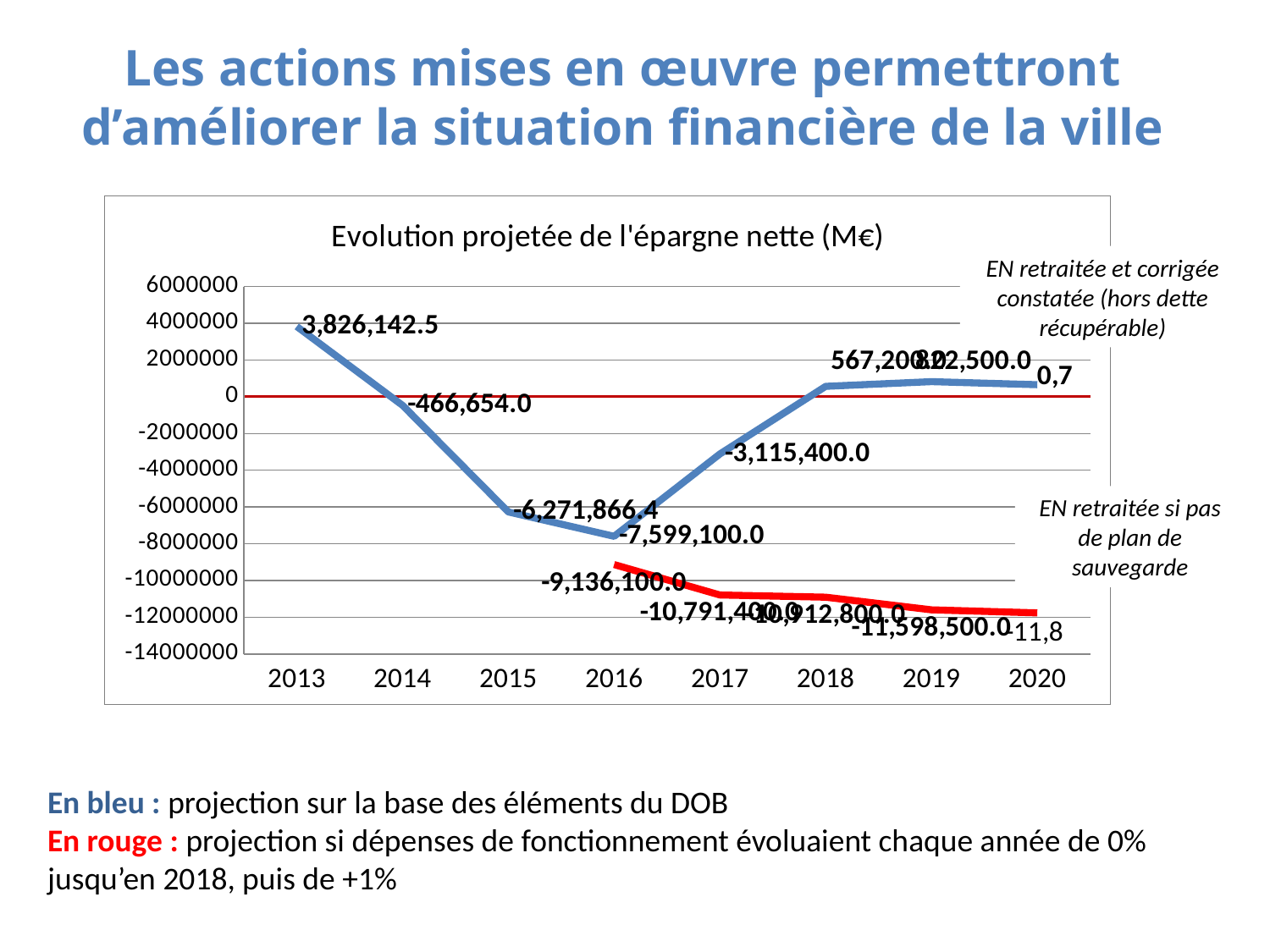
What is the value of the red line in 2019? -11,598,500.0 Does the blue line rise or fall between 2013 and 2016? fall What is the value of the red line (EN retraitée si pas de plan de sauvegarde) in 2016? -9,136,100.0 How many years are shown on the x axis? 8 In which year does the blue line reach its lowest value? 2016 In which year does the blue line reach its highest value? 2013 What is the value of the blue line in 2015? -6,271,866.4 What is the title of the chart? Evolution projetée de l'épargne nette (M€) What kind of chart is shown on the slide? line chart What is the value of the blue line (EN retraitée et corrigée constatée) in 2013? 3,826,142.5 What is the value of the blue line in 2017? -3,115,400.0 What is the value of the blue line in 2014? -466,654.0